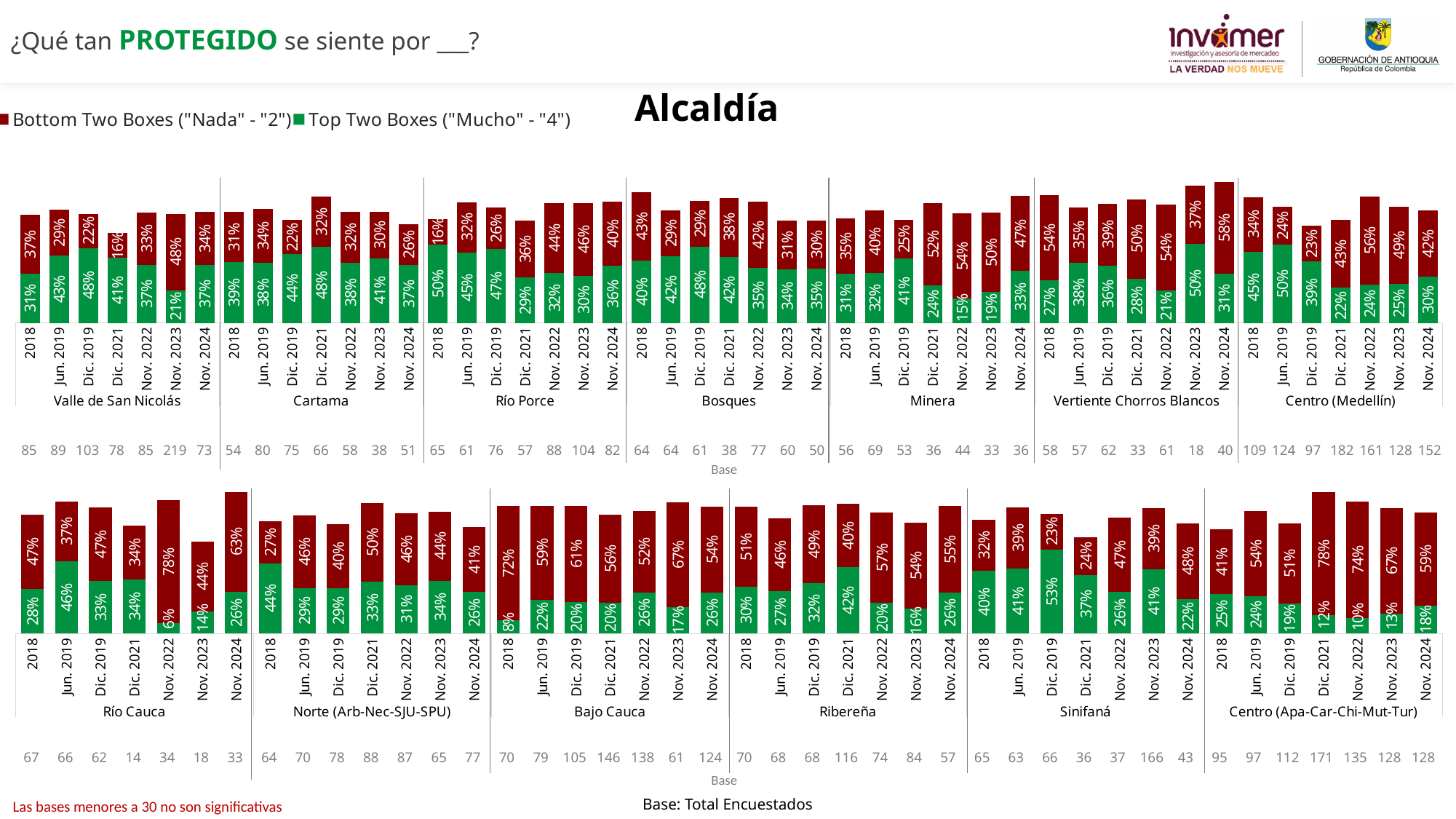
In the top chart, which period has the highest Top Two Boxes value for Centro (Medellín)? Jun. 2019 How many series does the legend list? 2 What kind of chart is shown on the slide? Stacked bar chart In the top chart, which is larger for Minera in Nov. 2022: the Bottom Two Boxes value or the Top Two Boxes value? Bottom Two Boxes In the bottom chart, what is the total of the stacked bar for Sinifaná in Dic. 2019? 76% In the bottom chart, what is the Bottom Two Boxes value for Río Cauca in Nov. 2022? 78% How many time periods are shown for each subregion in the bottom chart? 7 In the top chart, what is the Top Two Boxes value for Valle de San Nicolás in Nov. 2023? 21% In the top chart, what is the Bottom Two Boxes value for Vertiente Chorros Blancos in Nov. 2024? 58% In the top chart, what is the total of the stacked bar for Río Porce in 2018? 66% In the bottom chart, which period has the lowest Top Two Boxes value for Río Cauca? Nov. 2022 In the bottom chart, what is the difference between the Bottom Two Boxes values for Bajo Cauca in 2018 and Nov. 2024? 18 percentage points